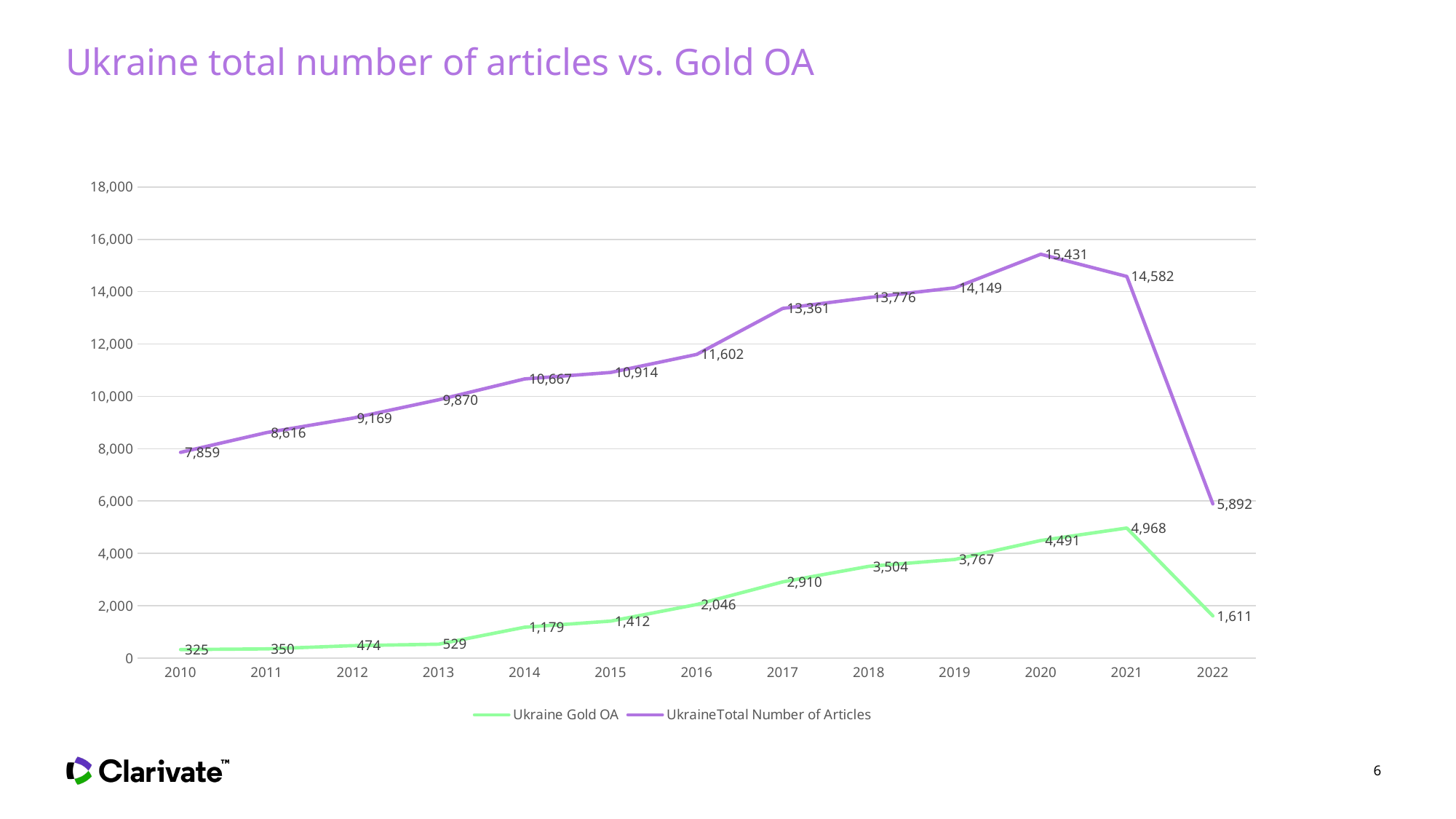
What kind of chart is shown on the slide? line chart How many series does the legend list? 2 What is the difference between Ukraine Total Number of Articles in 2021 and 2022? 8,690 Is the value for Ukraine Total Number of Articles in 2016 greater or less than 12,000? less In which year is Ukraine Gold OA lowest? 2010 What is the value of Ukraine Total Number of Articles in 2020? 15,431 In which year is Ukraine Total Number of Articles highest? 2020 What is the value of Ukraine Gold OA in 2017? 2,910 Does Ukraine Gold OA rise or fall from 2010 to 2021? rise How many years are shown on the x axis? 13 What is the value of Ukraine Gold OA in 2022? 1,611 Which is larger: Ukraine Gold OA in 2021 or Ukraine Gold OA in 2020? 2021